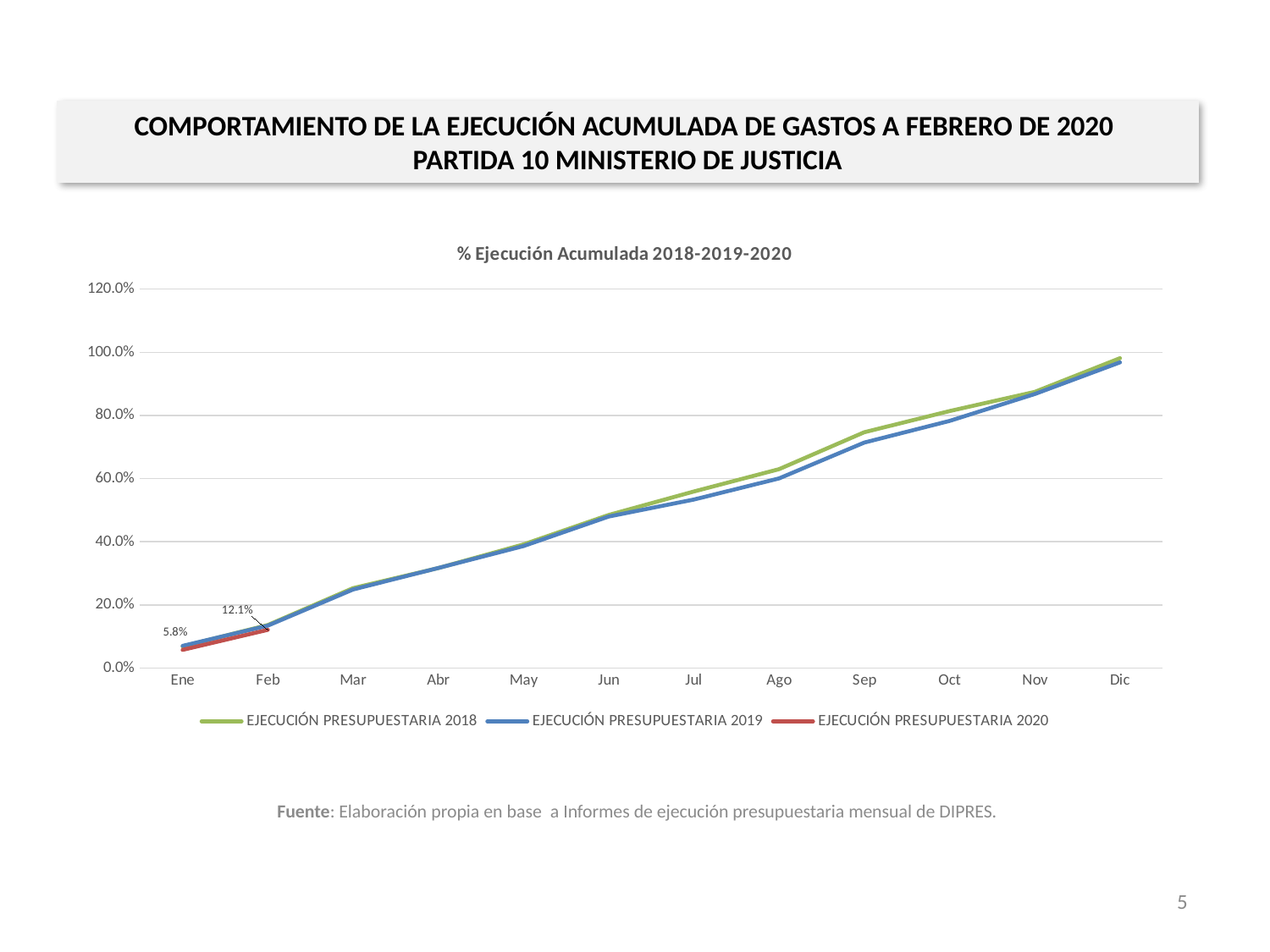
In Sep, which series has the higher value: EJECUCIÓN PRESUPUESTARIA 2018 or EJECUCIÓN PRESUPUESTARIA 2019? EJECUCIÓN PRESUPUESTARIA 2018 Do the values of EJECUCIÓN PRESUPUESTARIA 2019 rise or fall from Ene to Dic? rise What kind of chart is shown on the slide? line chart By how many percentage points did EJECUCIÓN PRESUPUESTARIA 2020 increase from Ene to Feb? 6.3 Is the value for EJECUCIÓN PRESUPUESTARIA 2018 in Dic greater or less than 80.0%? greater How many series does the chart legend list? 3 What is the title of the chart? % Ejecución Acumulada 2018-2019-2020 In which month does EJECUCIÓN PRESUPUESTARIA 2018 reach its highest value? Dic What is the value of EJECUCIÓN PRESUPUESTARIA 2020 in Feb? 12.1% Is the value for EJECUCIÓN PRESUPUESTARIA 2019 in Sep greater or less than 80.0%? less What is the value of EJECUCIÓN PRESUPUESTARIA 2020 in Ene? 5.8% How many months are shown along the x axis of the chart? 12